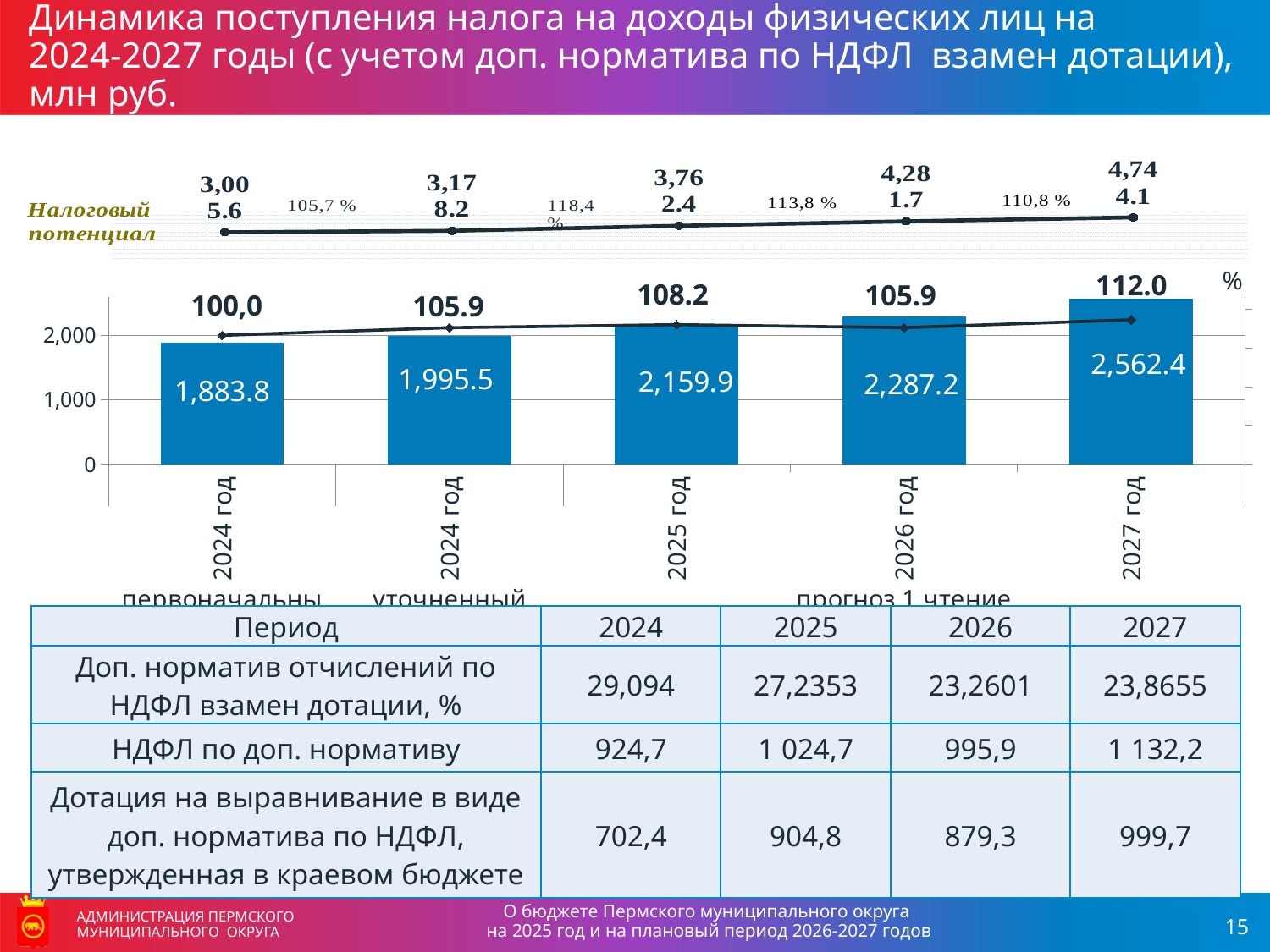
What is the value of the bar for 2026 год? 2,287.2 Which is larger: the bar for 2025 год or the second bar for 2024 год (уточненный)? 2025 год What is the value of the bar for 2027 год? 2,562.4 How many bars are shown in the chart? 5 Do the bar values rise or fall from left to right across the years? rise Which bar is the lowest? 2024 год (первоначальный), 1,883.8 What is the value of the bar for 2025 год? 2,159.9 What is the value of the first bar (2024 год, первоначальный)? 1,883.8 Is the value of the bar for 2026 год greater or less than 2,000? greater What type of chart is used to show the НДФЛ values? bar chart What is the difference between the bar for 2027 год and the bar for 2026 год? 275.2 Which year has the highest bar? 2027 год